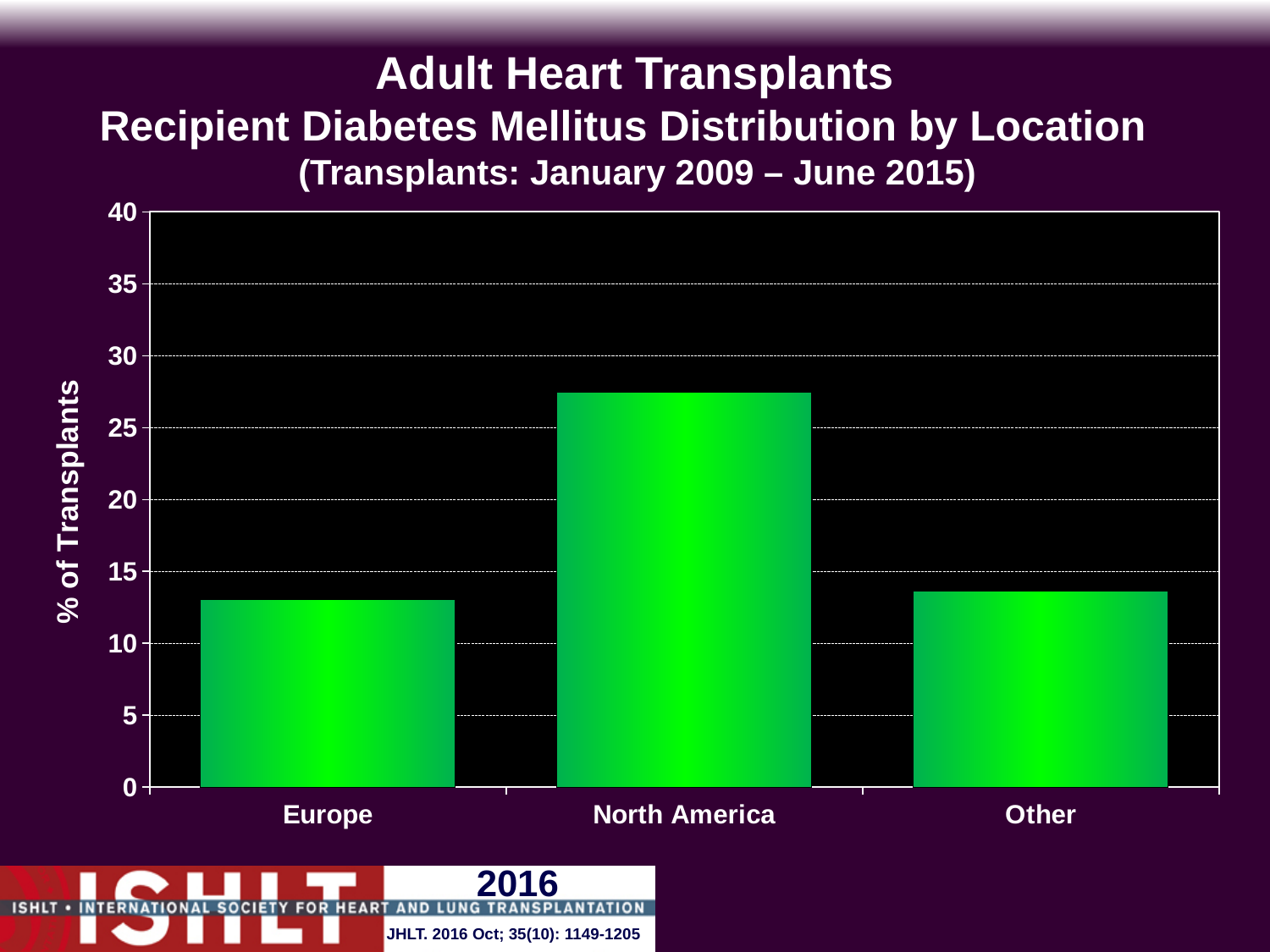
Is the value for Other greater or less than 10? greater What transplant date range is given in the chart title? January 2009 – June 2015 Is the value for North America greater or less than 25? greater Is the value for North America greater or less than 30? less How many location categories are shown on the x axis? 3 Which location has the highest % of transplants with recipient diabetes mellitus? North America What is the label of the y axis? % of Transplants Which is larger, the value for North America or the value for Europe? North America What kind of chart is shown on the slide? bar chart